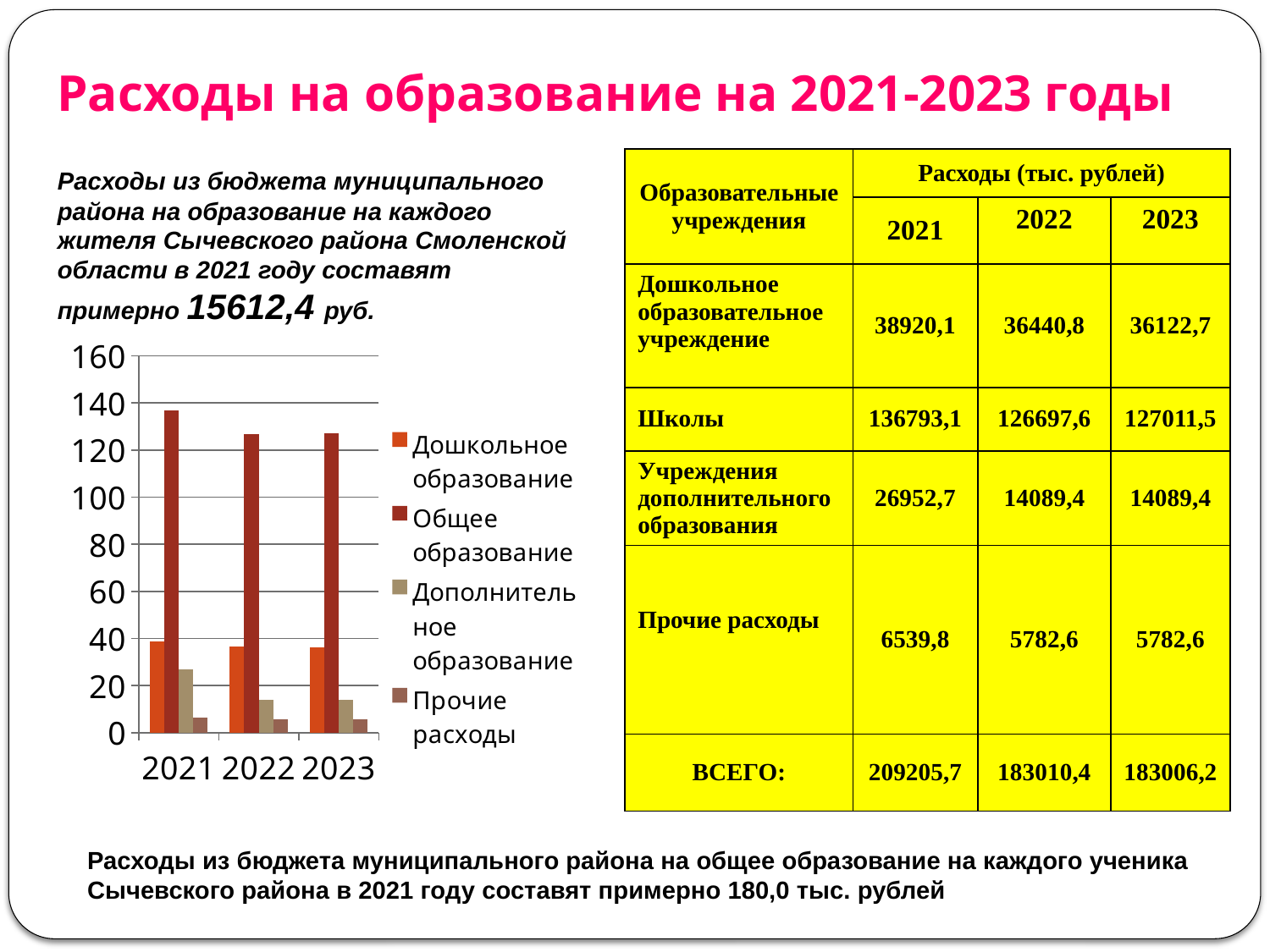
Is the value for Общее образование in 2021 greater or less than 120? greater How many series does the chart legend list? 4 Is the value for Дошкольное образование in 2021 greater or less than 60? less What kind of chart is shown on the slide? bar chart Which is larger: Дополнительное образование in 2021 or in 2022? 2021 How many years (categories) are shown on the x axis of the chart? 3 What is the highest tick value shown on the chart's vertical axis? 160 Which series has the shortest bar in 2021? Прочие расходы Which is larger in 2023: Дошкольное образование or Дополнительное образование? Дошкольное образование Is the value for Дополнительное образование in 2022 greater or less than 20? less Which series has the tallest bar in 2021? Общее образование Does the value for Общее образование rise or fall from 2021 to 2022? fall